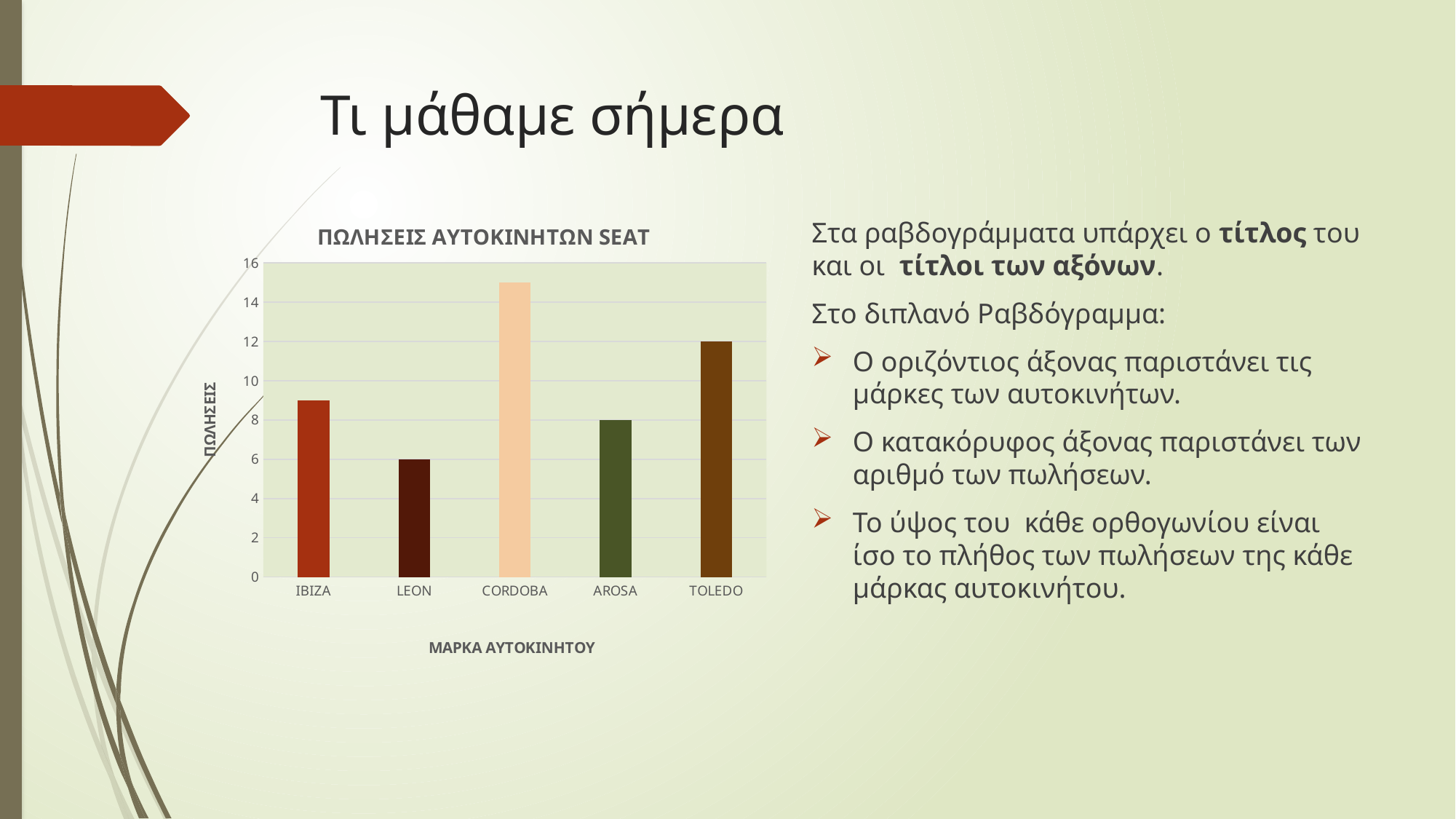
What kind of chart is shown on the slide? Bar chart Which has higher sales, TOLEDO or IBIZA? TOLEDO How many car models are shown on the horizontal axis? 5 Is the value for CORDOBA greater or less than 14? greater What is the value for TOLEDO? 12 What is the difference between the values for TOLEDO and LEON? 6 Which car model has the lowest sales? LEON What is the title of the chart? ΠΩΛΗΣΕΙΣ ΑΥΤΟΚΙΝΗΤΩΝ SEAT Which car model has the highest sales? CORDOBA What is the value for AROSA? 8 What is the value for LEON? 6 What is the title of the horizontal axis of the chart? ΜΑΡΚΑ ΑΥΤΟΚΙΝΗΤΟΥ